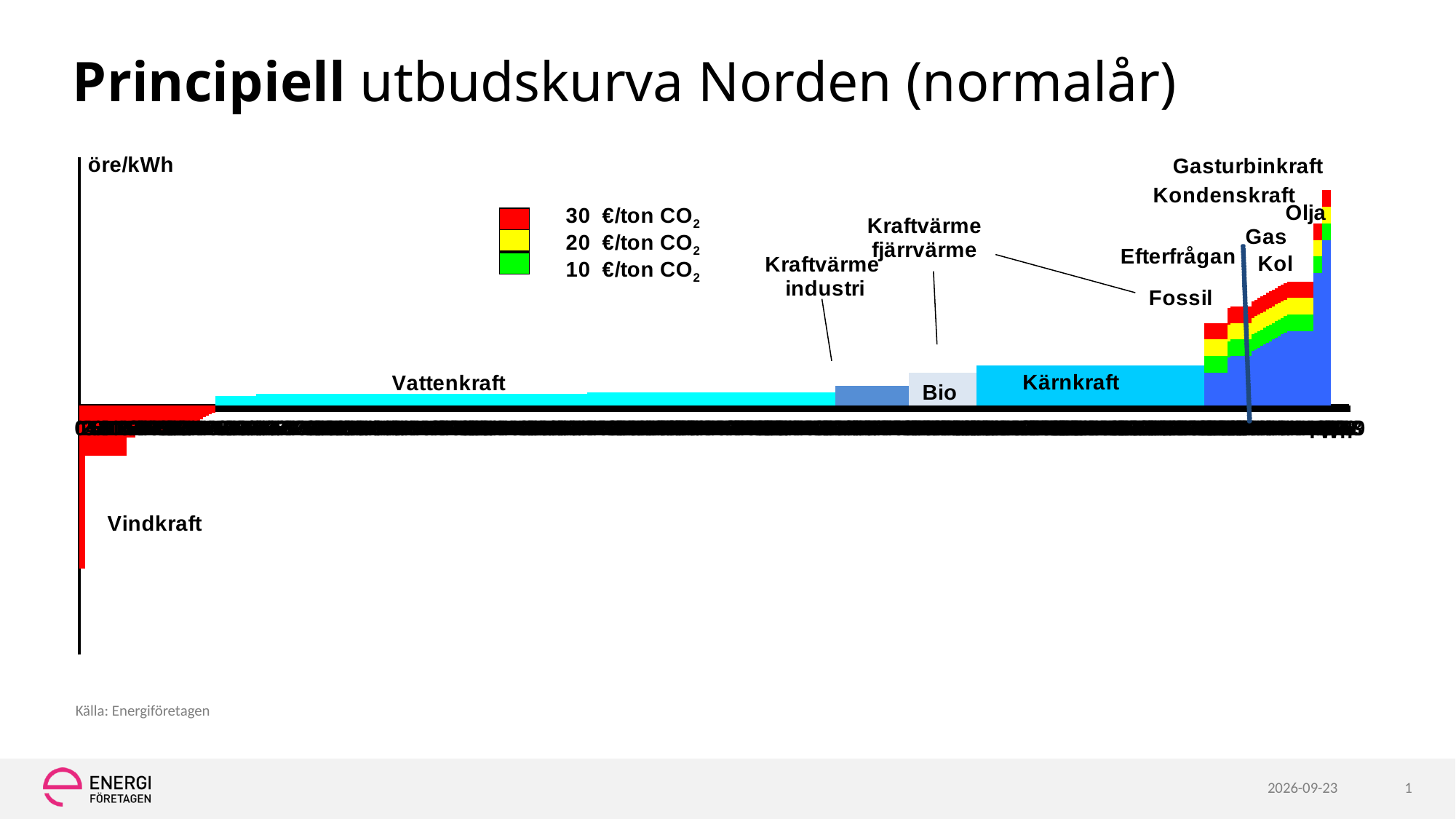
Which energy source occupies the widest segment along the horizontal axis? Vattenkraft What unit is shown on the vertical axis of the supply curve chart? öre/kWh Do the values on the supply curve rise or fall from left to right along the horizontal axis? Rise Which three fuels are labelled within the Fossil segment of the curve? Kol, Gas, Olja Which energy source is plotted at the far right, highest point of the supply curve? Gasturbinkraft Which energy source is plotted below the horizontal axis, at the lowest position on the supply curve? Vindkraft What does the dark vertical line crossing the curve near the right represent, according to its label? Efterfrågan Which energy source is labelled between Kraftvärme industri and Kärnkraft on the curve? Bio How many CO2 price levels does the legend list? 3 Is Fossil plotted higher or lower on the supply curve than Kärnkraft? Higher Which colour in the legend represents 30 €/ton CO2? Red Is Kärnkraft plotted higher or lower on the supply curve than Vattenkraft? Higher